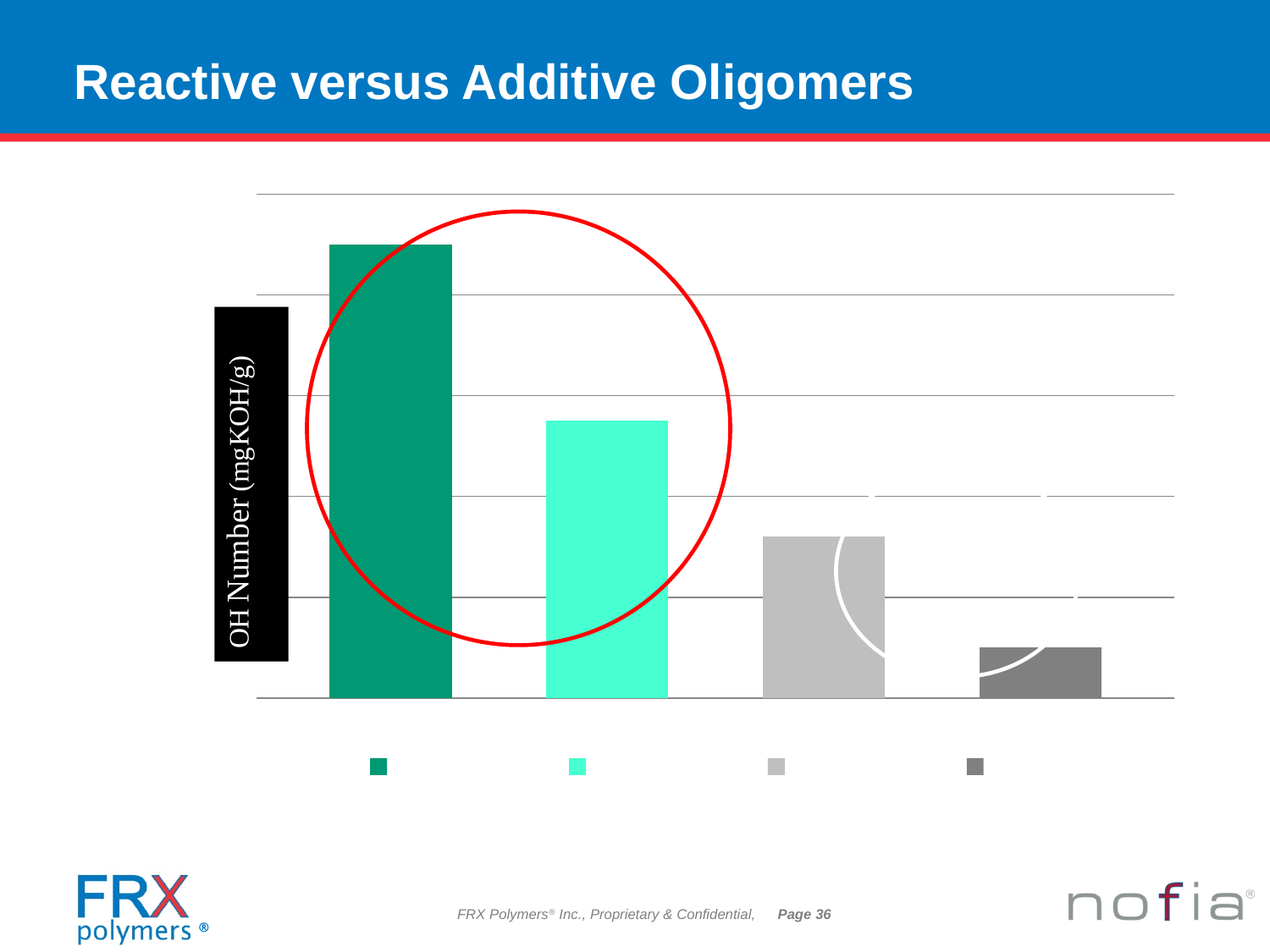
Which is taller, the dark green bar or the light teal bar? the dark green bar Which bar is the shortest in the chart? the fourth (dark grey) bar Do the bar heights rise or fall from left to right across the chart? fall How many bars are plotted in the chart? 4 How many entries does the legend below the chart show? 4 What is the label on the vertical axis of the chart? OH Number (mgKOH/g) Which is taller, the light grey bar or the dark grey bar? the light grey bar Which bar is the tallest in the chart: the first (dark green), second (light teal), third (light grey) or fourth (dark grey)? the first (dark green) bar Which bars are enclosed by the red circle drawn on the chart? the first two bars (dark green and light teal) What kind of chart is shown on the slide? bar chart